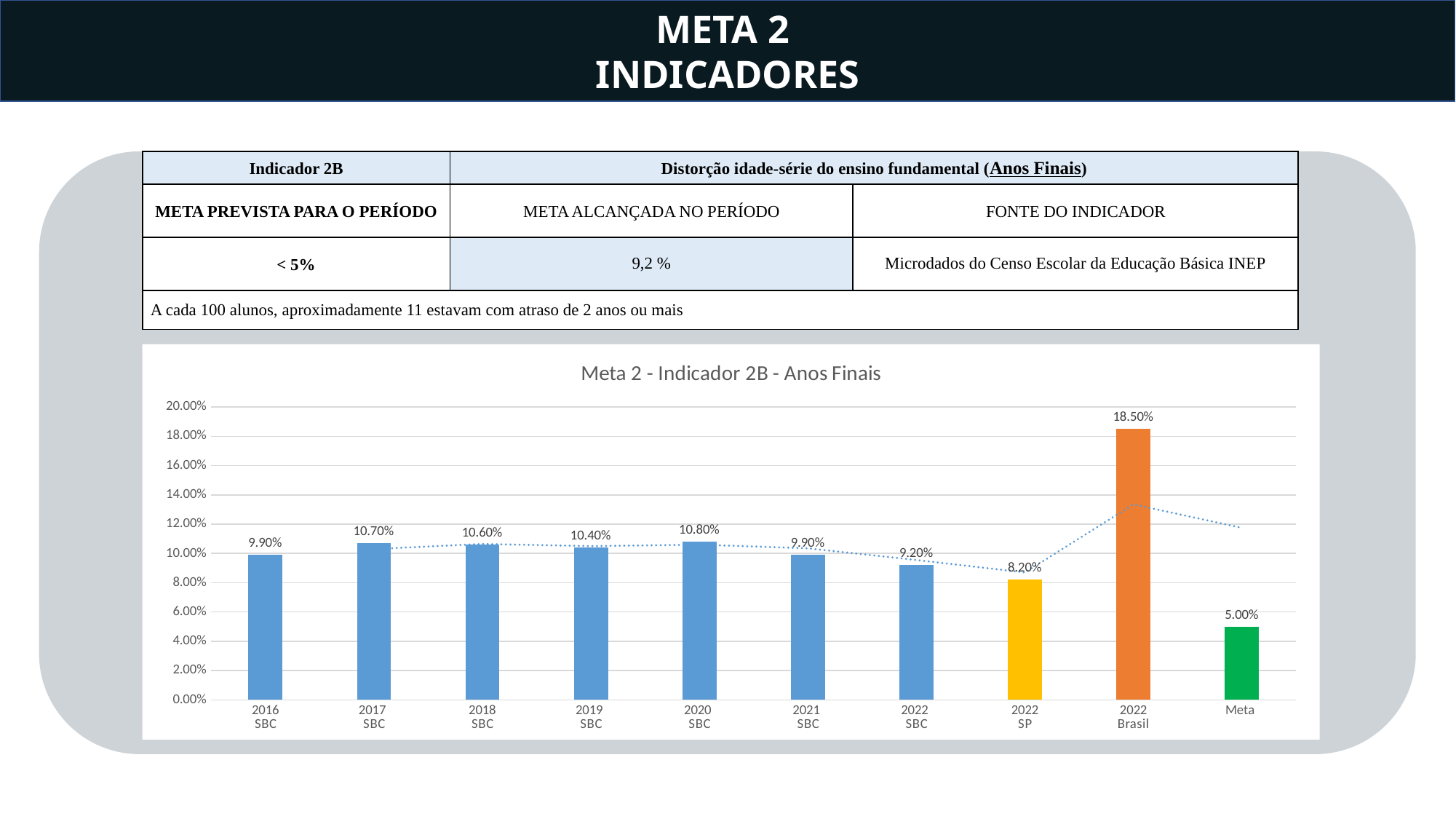
Which category has the lowest value? Meta What kind of chart is this? Bar chart How many bars are shown in the chart? 10 Which category has the highest value? 2022 Brasil Which is larger, 2017 SBC or 2020 SBC? 2020 SBC What is the value for 2016 SBC? 9.90% What is the value for 2022 SP? 8.20% Do the SBC values rise or fall from 2020 to 2022? Fall What is the value for Meta? 5.00% What is the title of the chart? Meta 2 - Indicador 2B - Anos Finais What is the value for 2022 Brasil? 18.50% What is the difference between 2022 Brasil and 2022 SBC? 9.30%